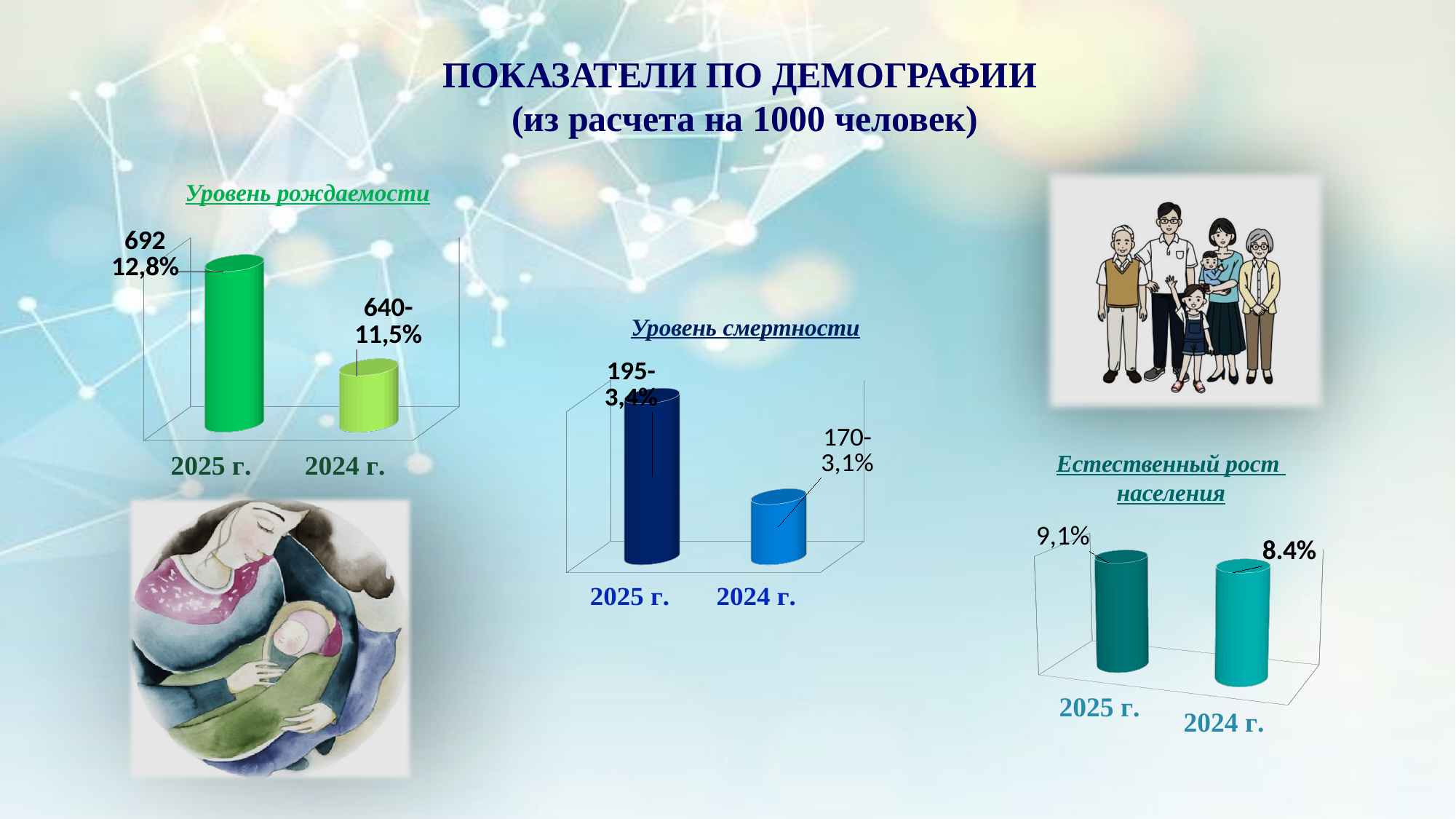
In the 'Уровень рождаемости' chart, what percentage is shown for 2025 г.? 12,8% What kind of chart is the 'Естественный рост населения' chart? Bar chart In the 'Уровень смертности' chart, what count is shown for 2025 г.? 195 In the 'Уровень смертности' chart, which year has the lower bar? 2024 г. In the 'Уровень смертности' chart, what percentage is shown for 2024 г.? 3,1% In the 'Уровень рождаемости' chart, what count is shown for 2025 г.? 692 In the 'Естественный рост населения' chart, what value is shown for 2025 г.? 9,1% In the 'Уровень рождаемости' chart, what percentage is shown for 2024 г.? 11,5% How many bars does the 'Уровень смертности' chart have? 2 In the 'Уровень рождаемости' chart, which year has the higher bar? 2025 г. In the 'Уровень рождаемости' chart, what is the difference between the counts for 2025 г. and 2024 г.? 52 In the 'Естественный рост населения' chart, what value is shown for 2024 г.? 8.4%